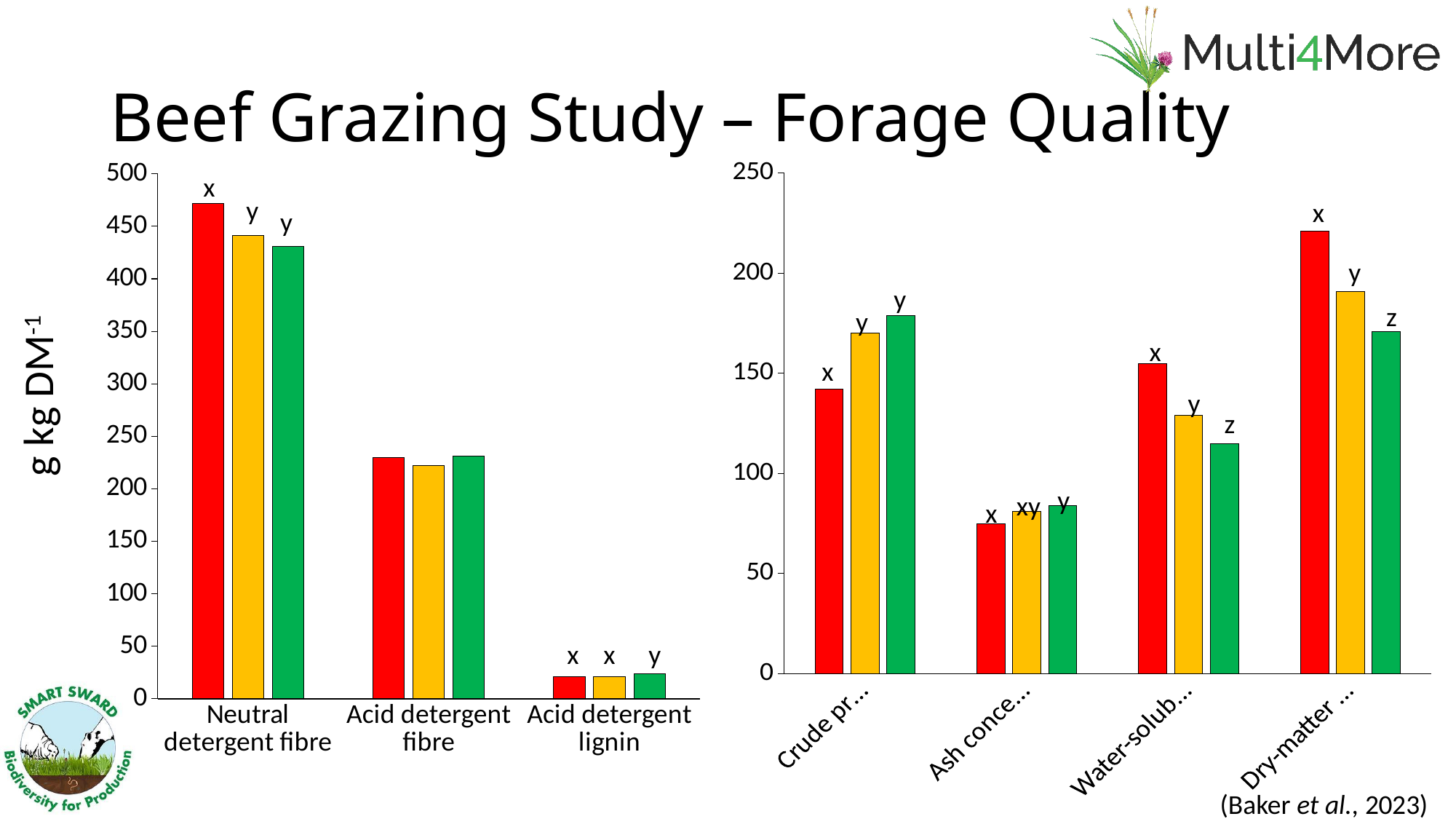
In the left chart, is the red bar for Neutral detergent fibre greater or less than 450? greater In the left chart, is the yellow bar for Acid detergent fibre greater or less than 250? less How many categories are shown on the x axis of the right chart? 4 In the right chart, is the green bar for the 'Water-solub…' category greater or less than 150? less In the right chart, for the 'Crude pr…' category, which is larger: the red bar or the green bar? the green bar What kind of chart is the left chart? bar chart What is the y-axis label of the left chart? g kg DM-1 How many categories are shown on the x axis of the left chart? 3 In the left chart, for Neutral detergent fibre, which is larger: the red bar or the green bar? the red bar In the left chart, which category has the lowest values? Acid detergent lignin In the left chart, which category has the highest values? Neutral detergent fibre